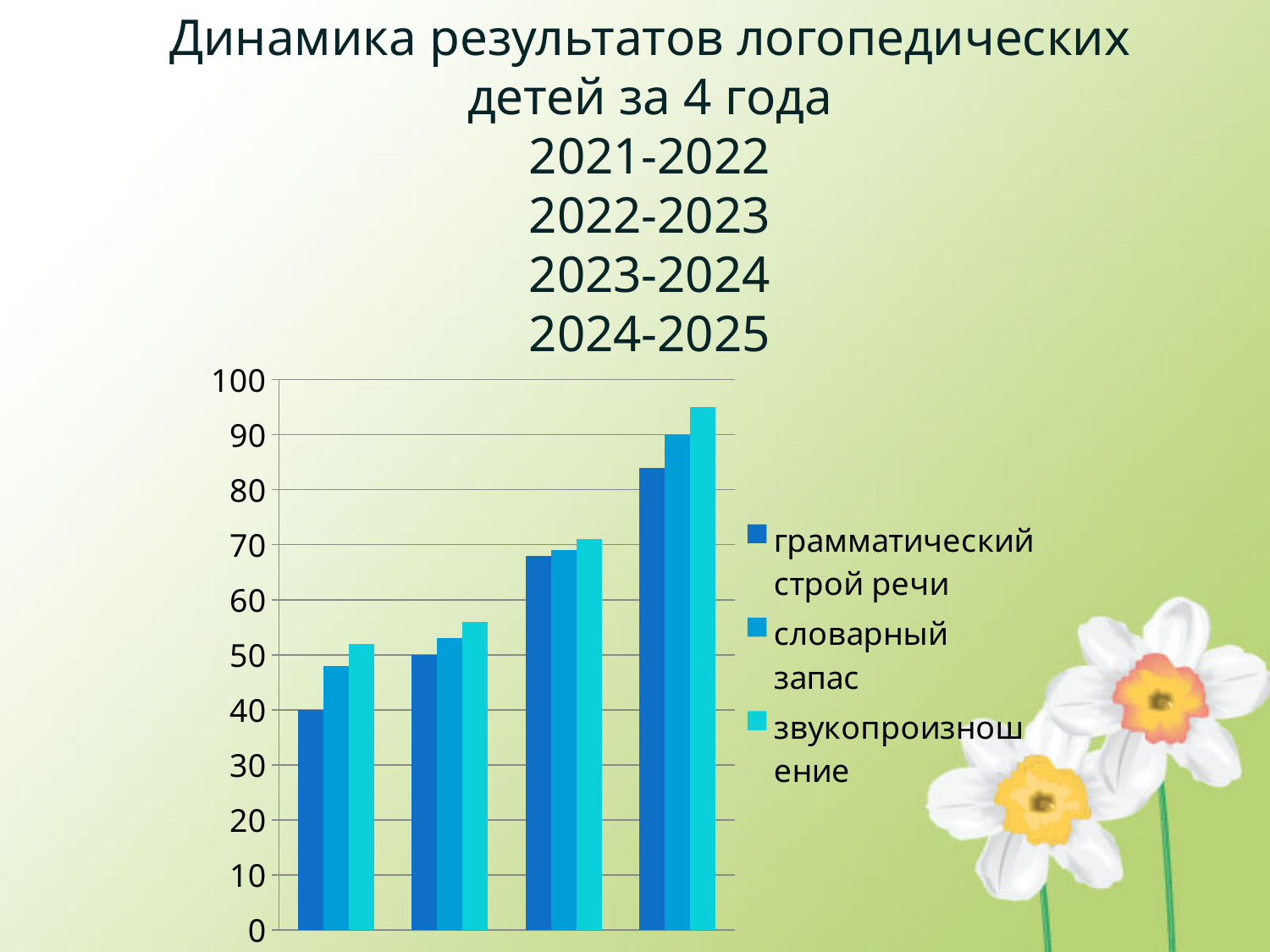
In the rightmost group of bars, is the value for звукопроизношение greater or less than 90? greater How many series does the legend list? 3 By how much does the value for грамматический строй речи in the second group exceed its value in the first group? 10 In the third group of bars from the left, is the value for грамматический строй речи greater or less than 70? less In the leftmost group of bars, which is larger: звукопроизношение or грамматический строй речи? звукопроизношение In the first (leftmost) group of bars, what is the value for грамматический строй речи? 40 What type of chart is shown on the slide? bar chart In the fourth (rightmost) group of bars, what is the value for словарный запас? 90 Do the values for each series rise or fall from the leftmost group to the rightmost group? rise How many groups of bars are plotted in the chart? 4 In the second group of bars from the left, what is the value for грамматический строй речи? 50 Which series is shown in the lightest (cyan) colour in the legend? звукопроизношение